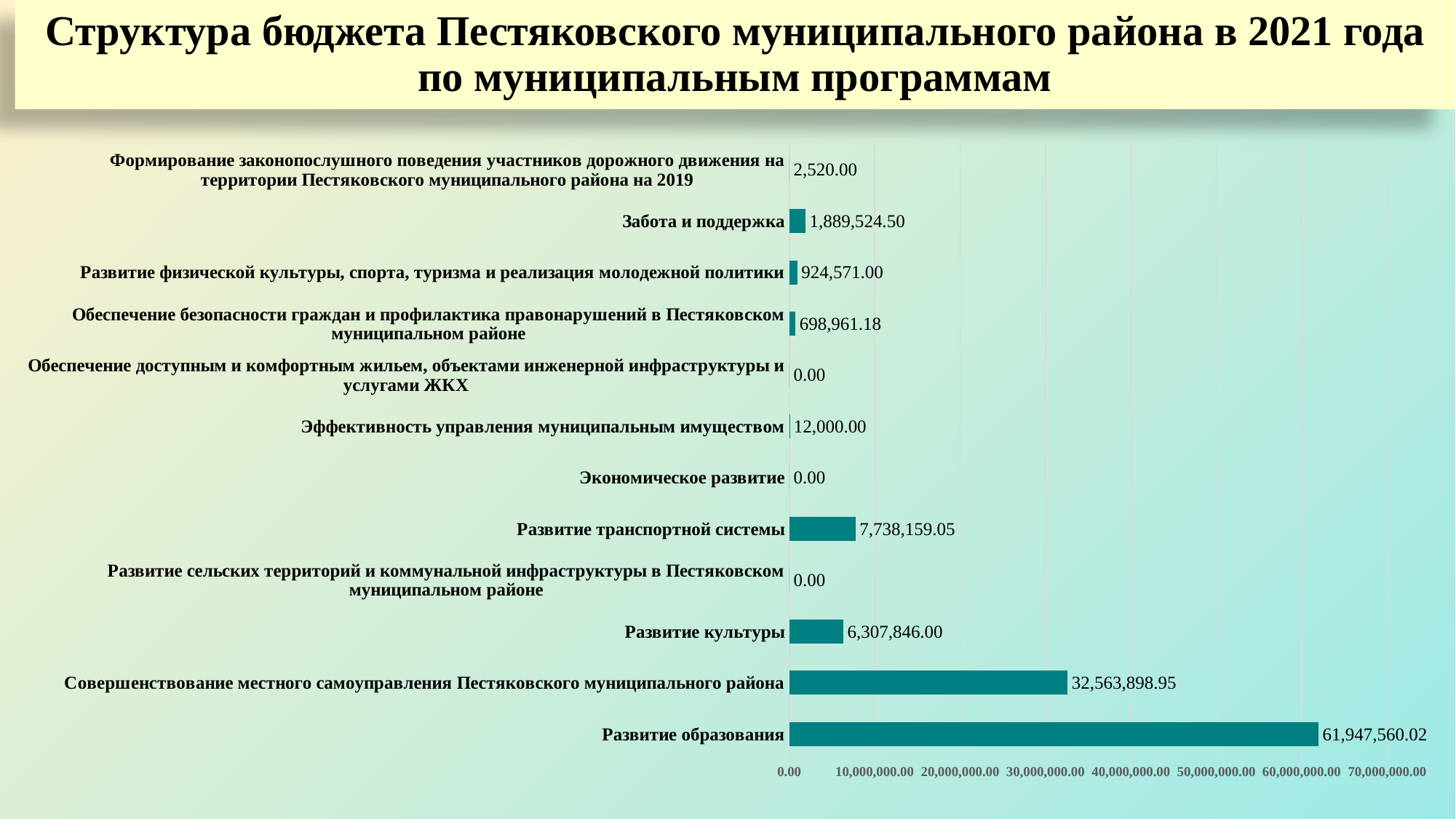
What is the value for Совершенствование местного самоуправления Пестяковского муниципального района? 32,563,898.95 How many programmes in the chart have a value of 0.00? 3 What is the value for Забота и поддержка? 1,889,524.50 What is the value for Развитие транспортной системы? 7,738,159.05 What is the value for Развитие образования? 61,947,560.02 Which programme has the highest value in the chart? Развитие образования What type of chart is shown on the slide? Bar chart What is the highest tick value shown on the horizontal axis? 70,000,000.00 How many municipal programmes (categories) are plotted in the chart? 12 What is the difference between the values for Развитие образования and Совершенствование местного самоуправления Пестяковского муниципального района? 29,383,661.07 Is the value for Развитие образования greater or less than 60,000,000.00? greater Which is larger: the value for Развитие транспортной системы or the value for Развитие культуры? Развитие транспортной системы